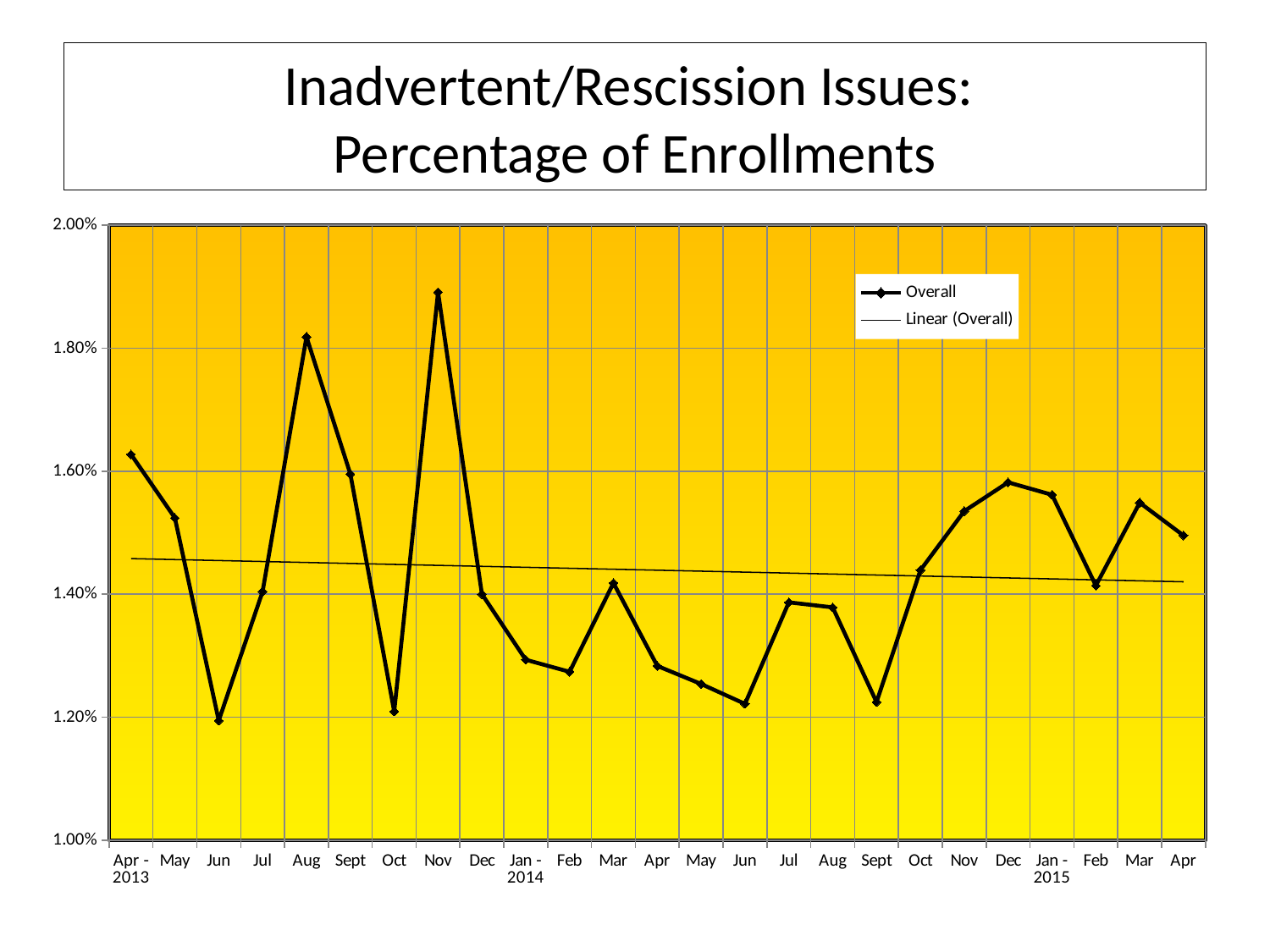
Is the Overall value for Nov 2013 greater or less than 1.80%? greater How many entries does the legend list? 2 What are the two entries listed in the legend? Overall and Linear (Overall) Is the Overall value for Jun 2013 greater or less than 1.40%? less Is the Overall value for Sept 2014 greater or less than 1.40%? less Which is larger, the Overall value for Nov 2013 or for Aug 2013? Nov 2013 Does the linear trendline rise or fall from left to right across the chart? Falls Which month has the highest Overall value? Nov 2013 What kind of chart is shown on the slide? Line chart What is the title of the chart? Inadvertent/Rescission Issues: Percentage of Enrollments How many monthly data points are plotted on the Overall line? 25